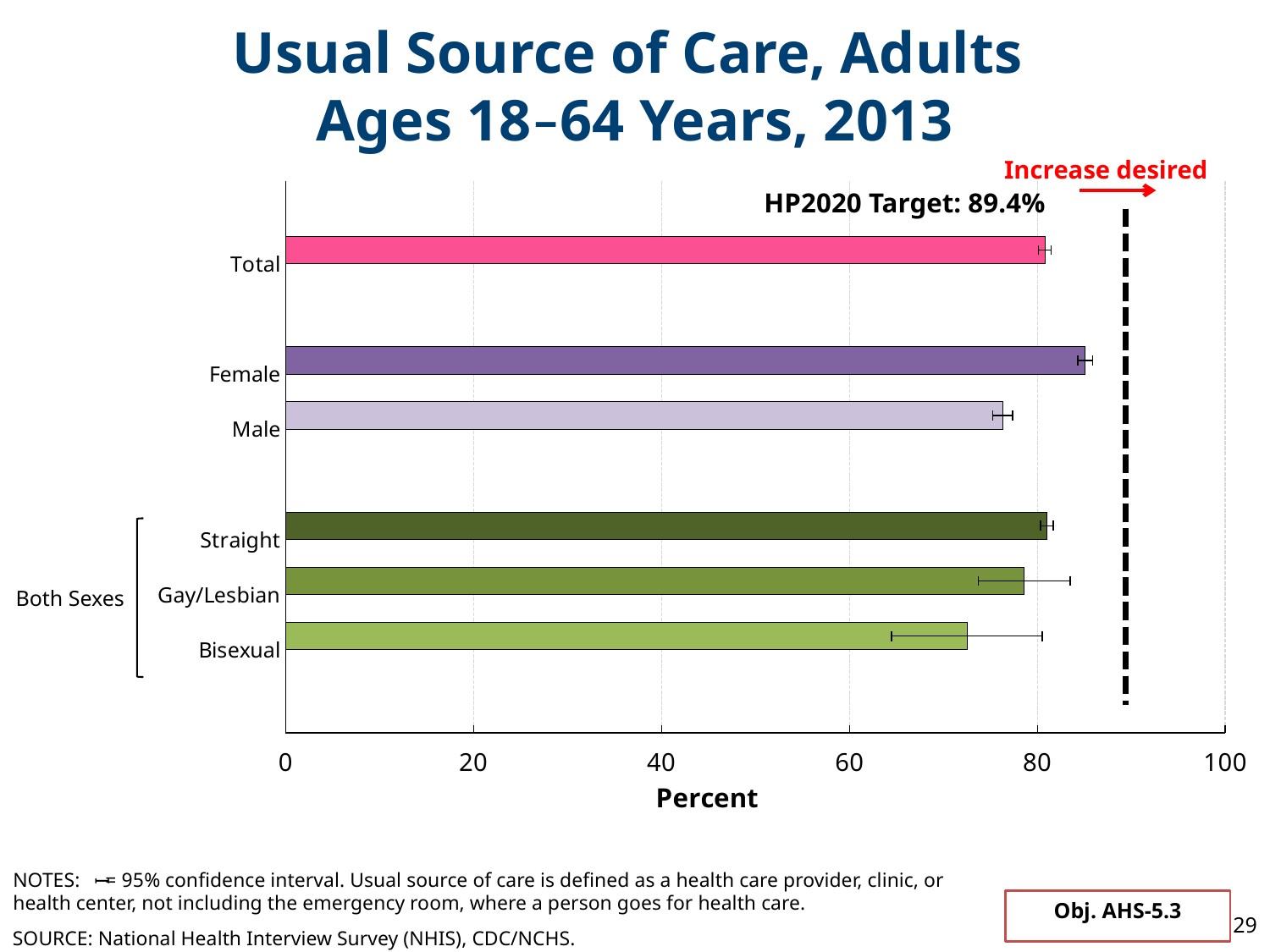
Which category has the highest value in the chart? Female Is the value for Male greater or less than 80? less Which is larger, the value for Female or the value for Male? Female What is the label of the x axis? Percent Is the value for Bisexual greater or less than 80? less What kind of chart is shown on the slide? bar chart What is the HP2020 Target shown on the chart? 89.4% Which category has the lowest value in the chart? Bisexual Is the value for Female greater or less than 80? greater Which is larger, the value for Straight or the value for Bisexual? Straight How many bars are plotted in the chart? 6